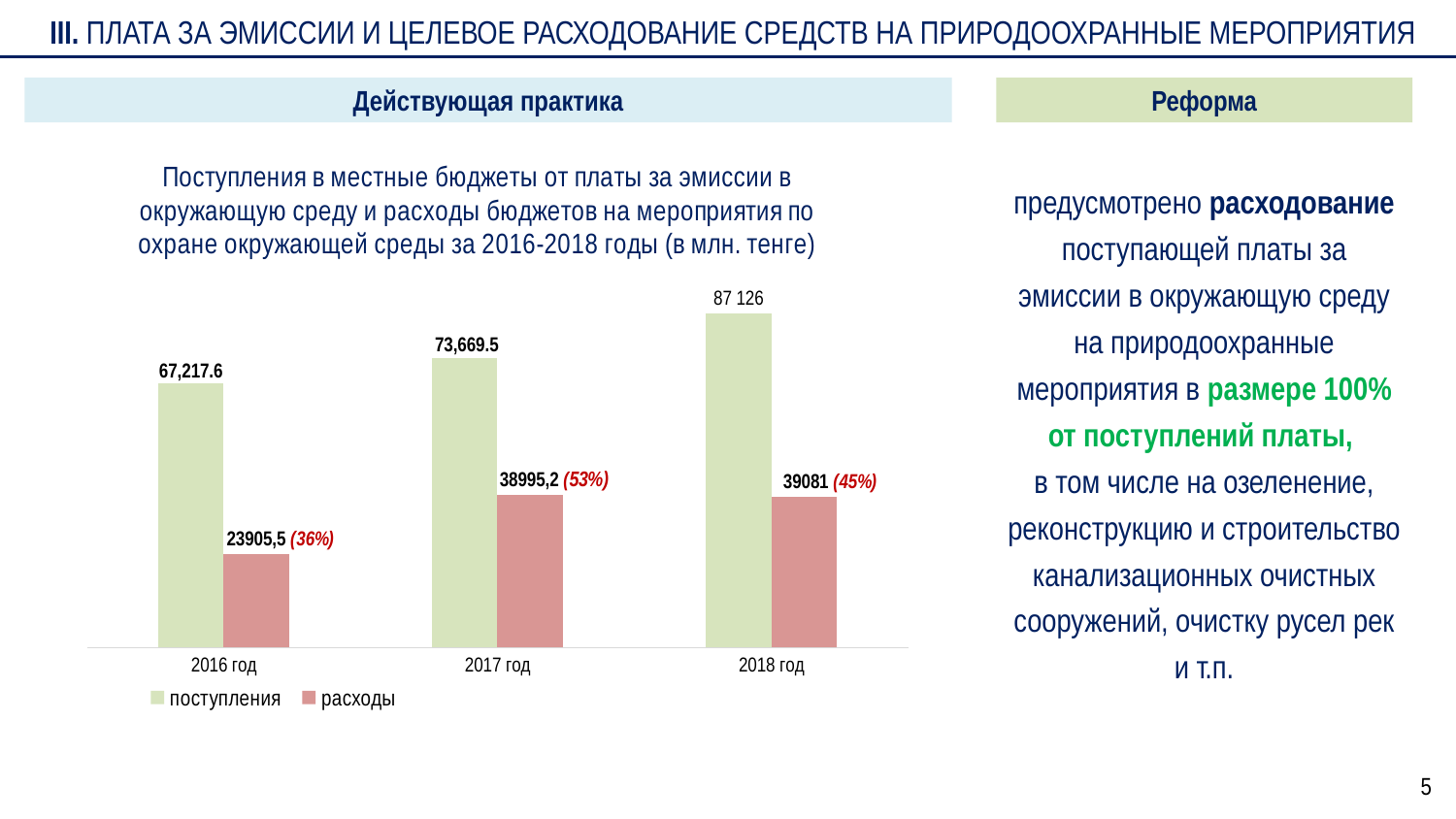
Which is larger in 2017 год: поступления or расходы? поступления What is the difference between поступления in 2018 год and 2017 год? 13,456.5 Which year has the lowest value of расходы? 2016 год Do the поступления values rise or fall from 2016 год to 2018 год? rise What is the value of расходы for 2017 год? 38995,2 How many years are shown on the x axis? 3 What is the value of поступления for 2016 год? 67,217.6 What type of chart is shown on the slide? bar chart Which year has the highest value of поступления? 2018 год What is the value of поступления for 2018 год? 87 126 How many series does the legend list? 2 What percentage is shown next to the расходы value for 2016 год? 36%